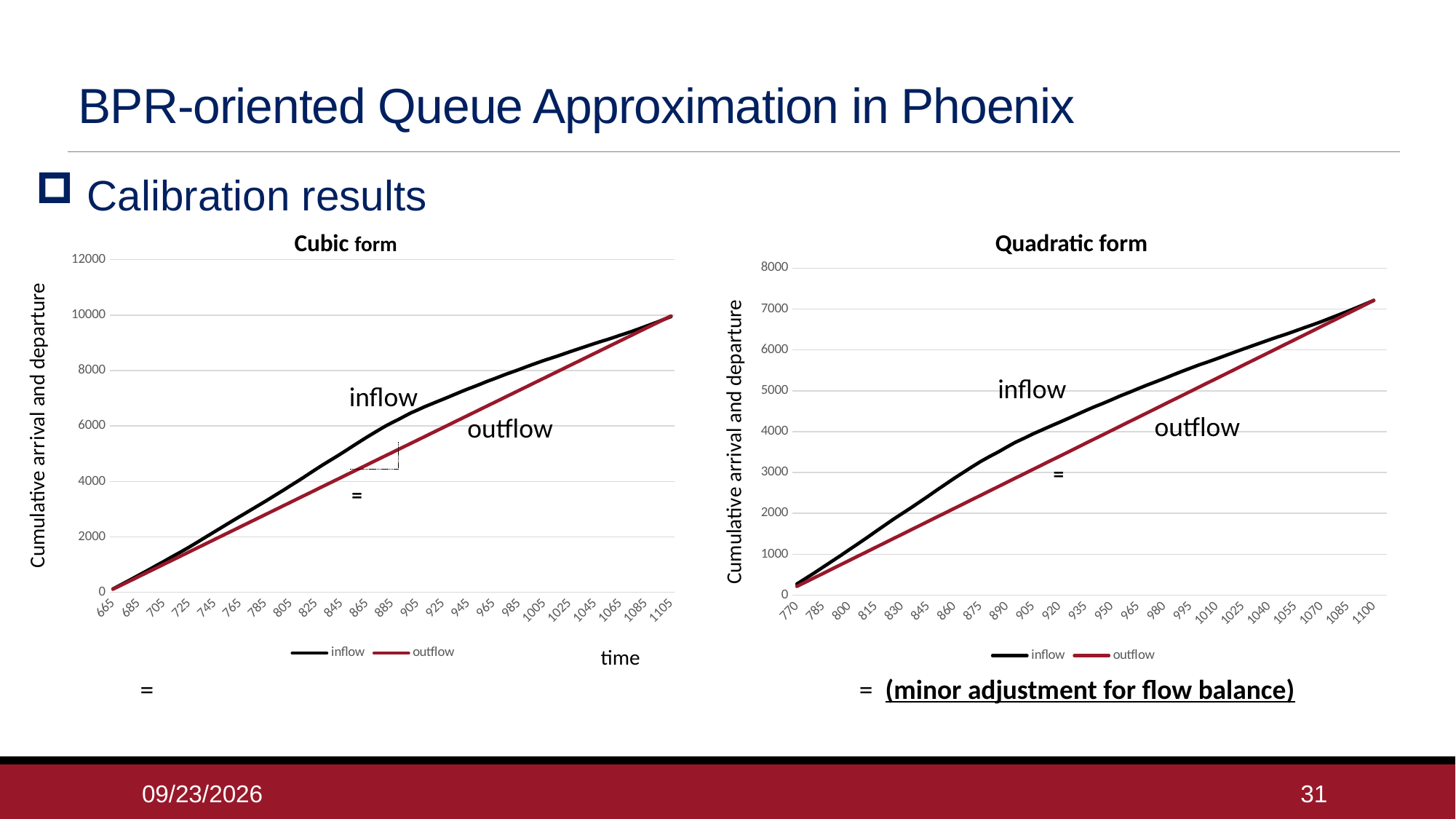
In the "Quadratic form" chart, does the outflow line rise or fall along the x axis? rise How many series does the legend of the "Cubic form" chart list? 2 What is the title of the y axis on the "Cubic form" chart? Cumulative arrival and departure What are the two series named in the legend of the "Quadratic form" chart? inflow and outflow In the "Quadratic form" chart, is the outflow value at time 935 greater or less than 4000? less In the "Cubic form" chart, at time 865, which series has the larger value, inflow or outflow? inflow How many time labels are shown on the x axis of the "Quadratic form" chart? 23 In the "Cubic form" chart, does the inflow line rise or fall as time increases along the x axis? rise In the "Cubic form" chart, is the inflow value at time 865 greater or less than 4000? greater What kind of chart is the "Cubic form" chart? line chart What kind of chart is the "Quadratic form" chart? line chart In the "Cubic form" chart, is the outflow value at time 905 greater or less than 4000? greater